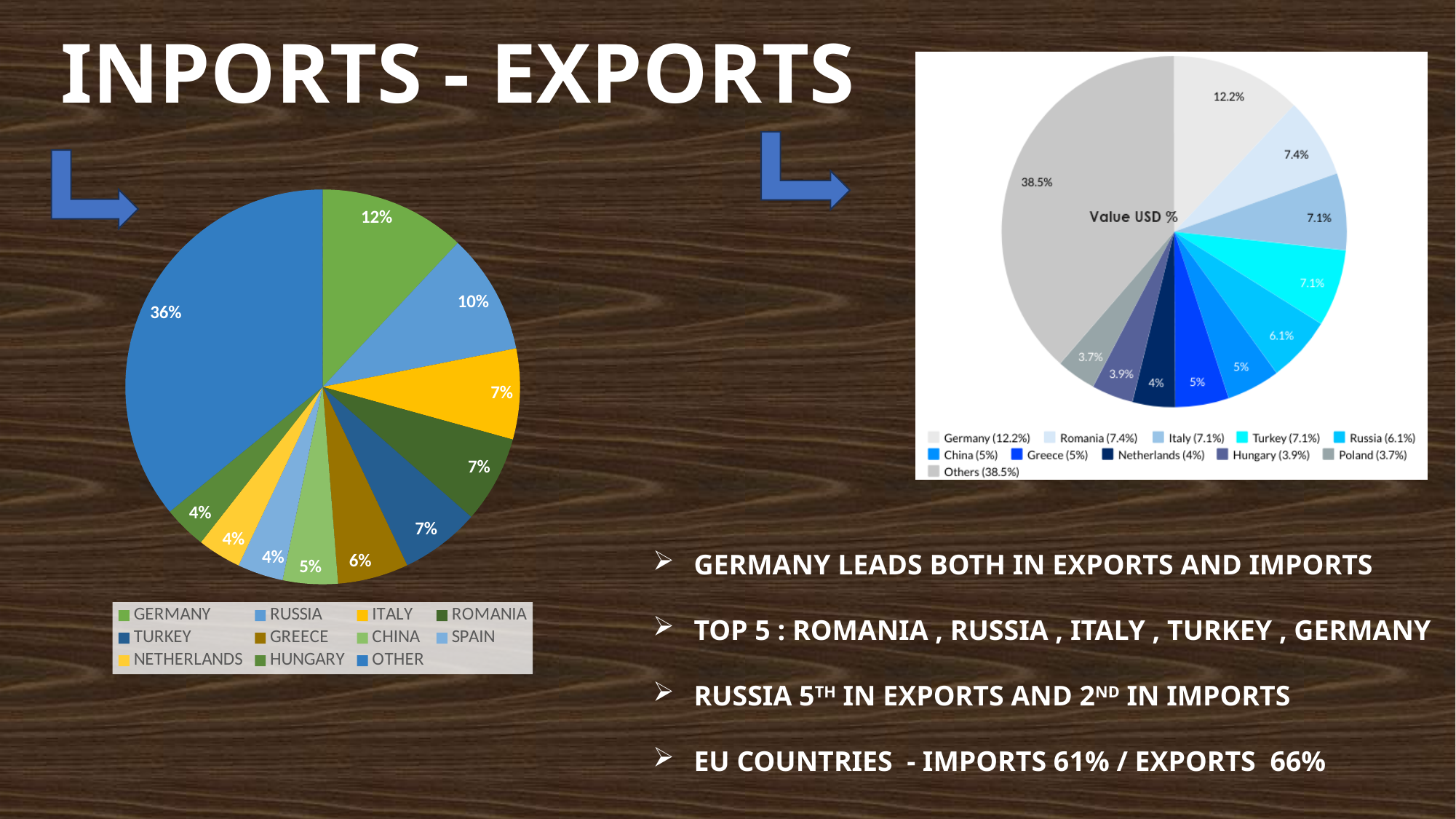
In the pie chart on the left, what share does Russia have? 10% In the pie chart on the left, which category has the largest slice? OTHER In the 'Value USD %' pie chart on the right, what share does Germany have? 12.2% In the pie chart on the left, what is the difference between the shares of Germany and Russia? 2% What type of chart is shown on the left of the slide? Pie chart In the pie chart on the left, how many categories does the legend list? 11 In the 'Value USD %' pie chart on the right, what share does Others have? 38.5% In the 'Value USD %' pie chart on the right, which named country has the smallest share? Poland In the 'Value USD %' pie chart on the right, what share does Romania have? 7.4% In the 'Value USD %' pie chart on the right, which is larger, the share of Russia or the share of Hungary? Russia In the pie chart on the left, what share does Greece have? 6% In the pie chart on the left, what share does Germany have? 12%